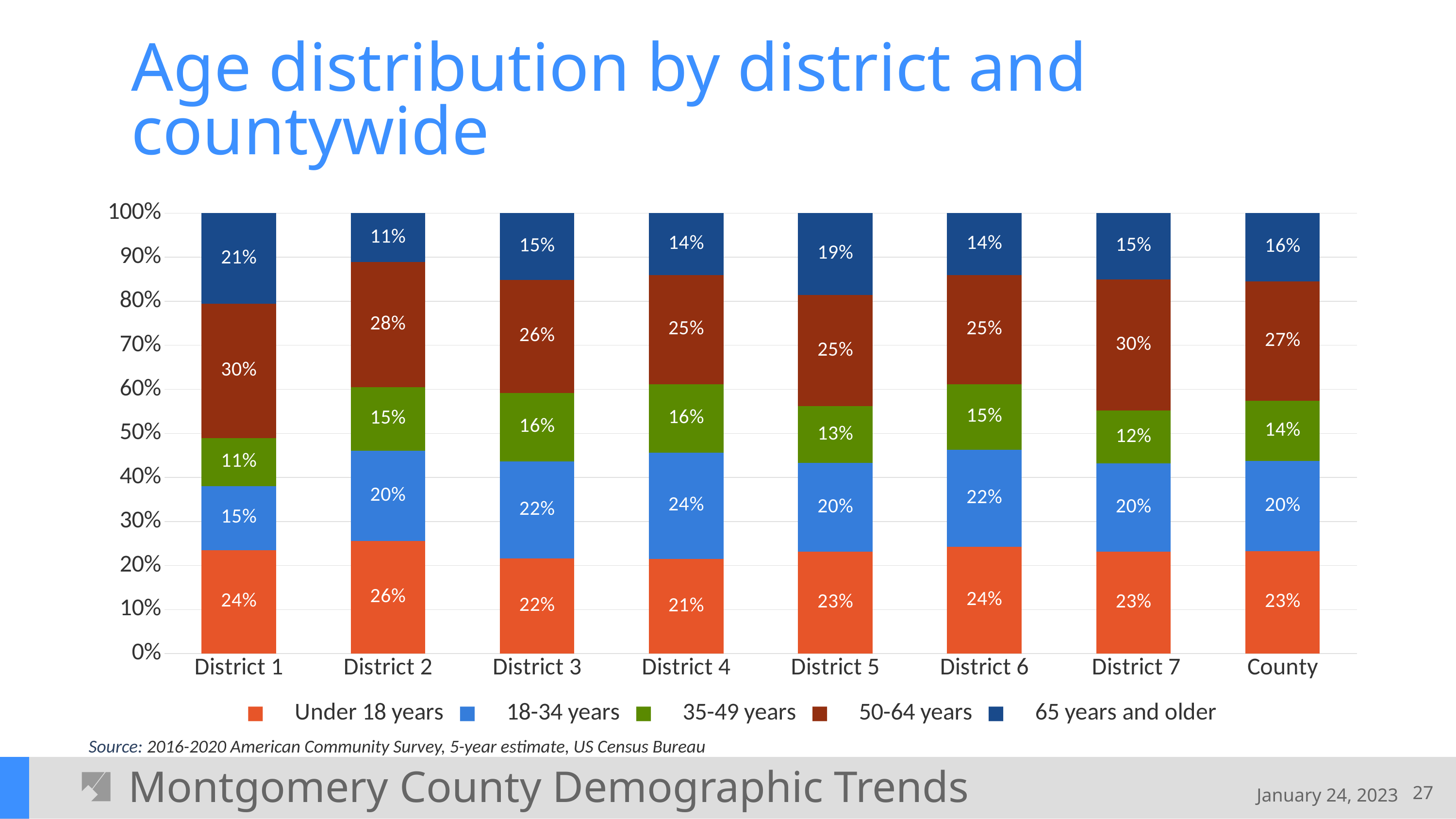
Is the 65 years and older share larger in District 5 or District 6? District 5 Which district has the lowest share of residents 65 years and older? District 2 What is the share of the 18-34 years group in District 4? 24% How many series does the legend list? 5 Which colour represents the 35-49 years group in the chart? Green What kind of chart is shown on the slide? Stacked bar chart What percentage of the County population is in the 50-64 years group? 27% Which district has the highest share of residents under 18 years? District 2 What percentage of District 1's population is 65 years and older? 21% Which category has the lowest share of residents aged 35-49 years? District 1 In District 1, how many percentage points larger is the 50-64 years share than the 35-49 years share? 19 percentage points How many categories are shown on the x axis? 8